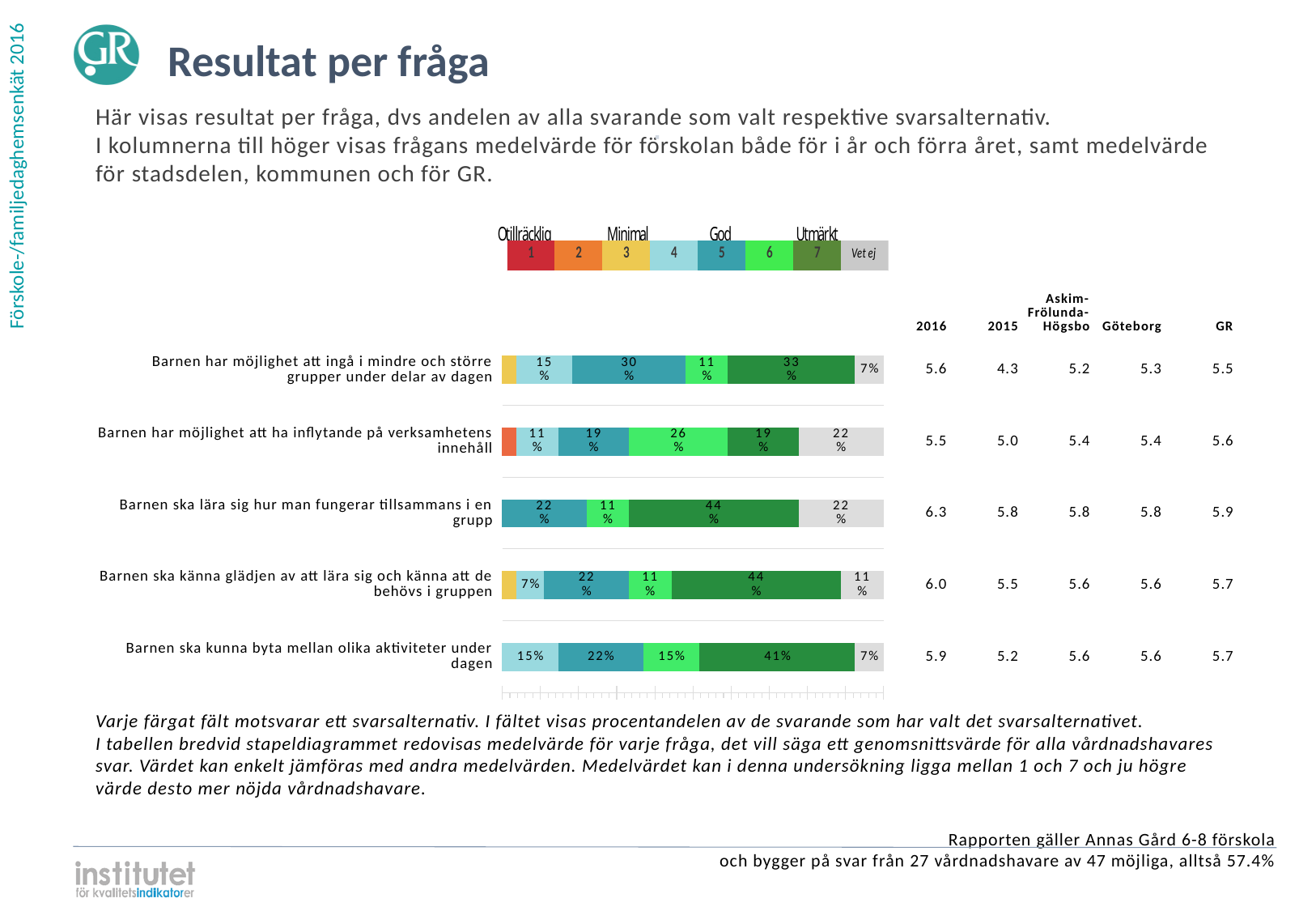
Which has a larger dark green (7) share: "Barnen har möjlighet att ingå i mindre och större grupper under delar av dagen" or "Barnen ska kunna byta mellan olika aktiviteter under dagen"? Barnen ska kunna byta mellan olika aktiviteter under dagen What percentage is shown for the light green (6) segment of "Barnen har möjlighet att ha inflytande på verksamhetens innehåll"? 26% What percentage of respondents answered "Vet ej" for "Barnen har möjlighet att ha inflytande på verksamhetens innehåll"? 22% What percentage is shown for the teal (5) segment of "Barnen har möjlighet att ingå i mindre och större grupper under delar av dagen"? 30% What percentage of respondents chose the dark green (7, Utmärkt) option for "Barnen ska kunna byta mellan olika aktiviteter under dagen"? 41% What are the four labelled response categories in the legend above the chart, besides "Vet ej"? Otillräcklig, Minimal, God, Utmärkt Which question has the highest 2016 mean value in the table next to the chart? Barnen ska lära sig hur man fungerar tillsammans i en grupp Which question has the largest "Vet ej" share? Barnen har möjlighet att ha inflytande på verksamhetens innehåll (22%), tied with Barnen ska lära sig hur man fungerar tillsammans i en grupp (22%) How many questions (categories) are plotted in the bar chart? 5 What kind of chart is shown on the slide? Stacked bar chart For "Barnen ska kunna byta mellan olika aktiviteter under dagen", what is the difference between the dark green (7) segment and the light blue (4) segment? 26 percentage points What is the 2016 mean value shown for "Barnen ska lära sig hur man fungerar tillsammans i en grupp"? 6.3